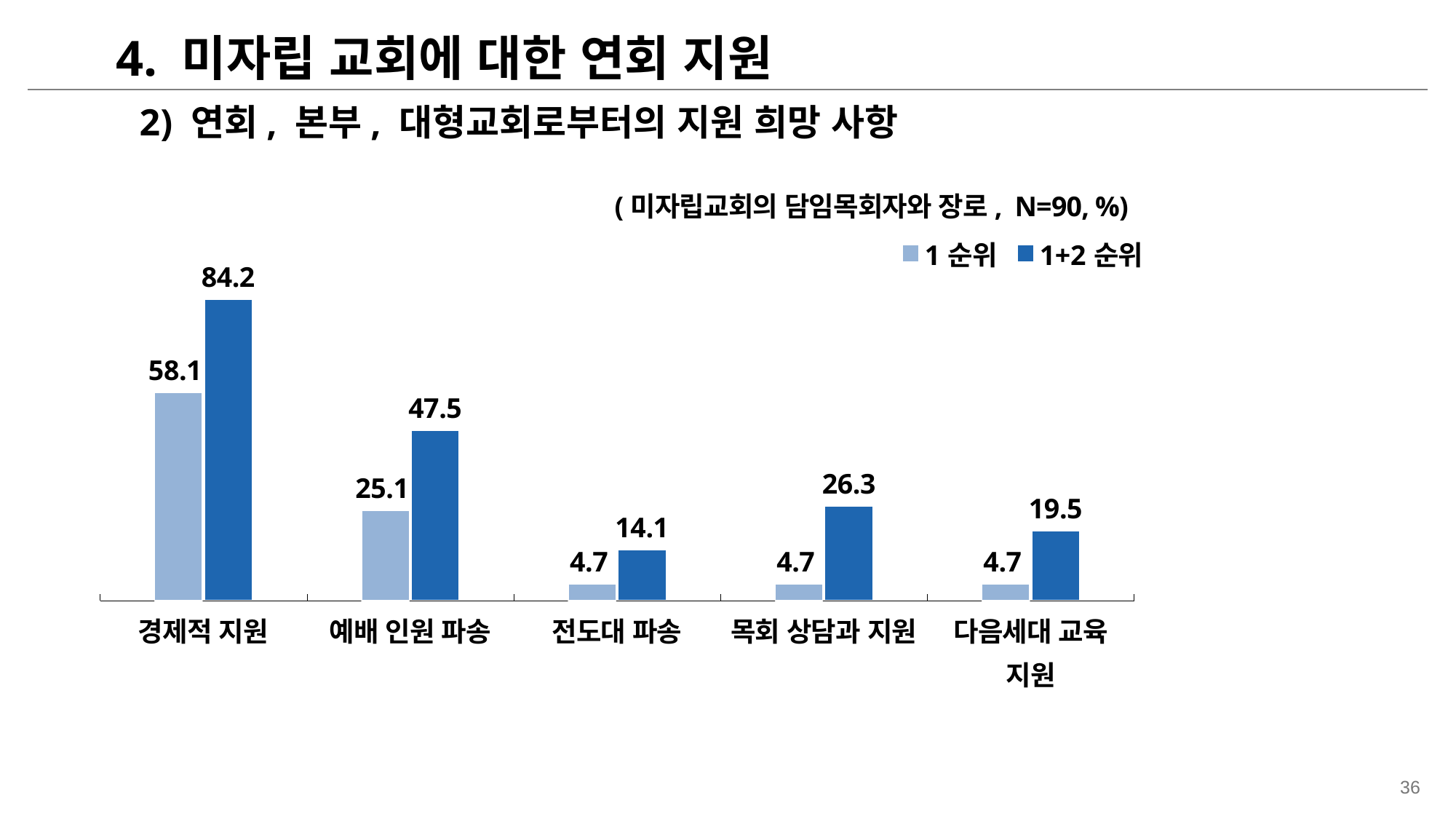
What is the 1+2 순위 value for 다음세대 교육 지원? 19.5 Which is larger: the 1+2 순위 value for 목회 상담과 지원 or for 다음세대 교육 지원? 목회 상담과 지원 How many series does the legend list? 2 Which category has the highest 1+2 순위 value? 경제적 지원 What is the 1+2 순위 value for 경제적 지원? 84.2 What is the difference between the 1+2 순위 values for 예배 인원 파송 and 목회 상담과 지원? 21.2 How many categories are shown on the x axis? 5 What is the difference between the 1+2 순위 and 1 순위 values for 경제적 지원? 26.1 What sample size (N) is stated above the chart? N=90 What kind of chart is shown on the slide? Bar chart Which category has the lowest 1+2 순위 value? 전도대 파송 What is the 1 순위 value for 예배 인원 파송? 25.1